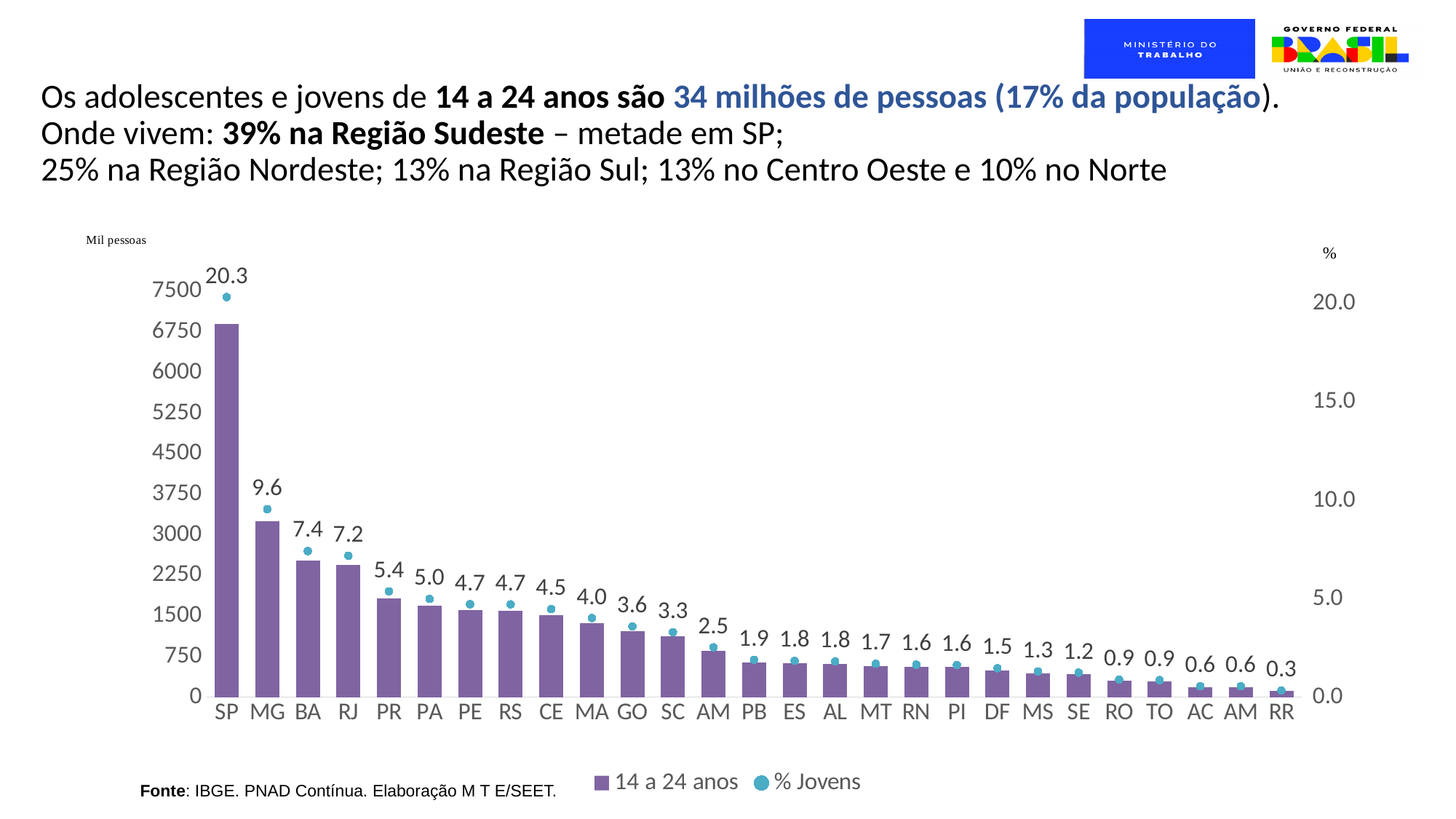
What is the % Jovens value for DF? 1.5 How many series does the legend list? 2 Is the 14 a 24 anos bar for MG greater or less than 3750 mil pessoas? less Which state has the lowest % Jovens value? RR What is the difference between the % Jovens values for SP and MG? 10.7 What is the % Jovens value for MG? 9.6 What kind of chart is used for the 14 a 24 anos series? bar chart Which state has the highest % Jovens value? SP How many states are shown on the x axis of the chart? 27 Is the 14 a 24 anos bar for SP greater or less than 6000 mil pessoas? greater What is the % Jovens value for SP? 20.3 Which has a larger % Jovens value, PR or PA? PR